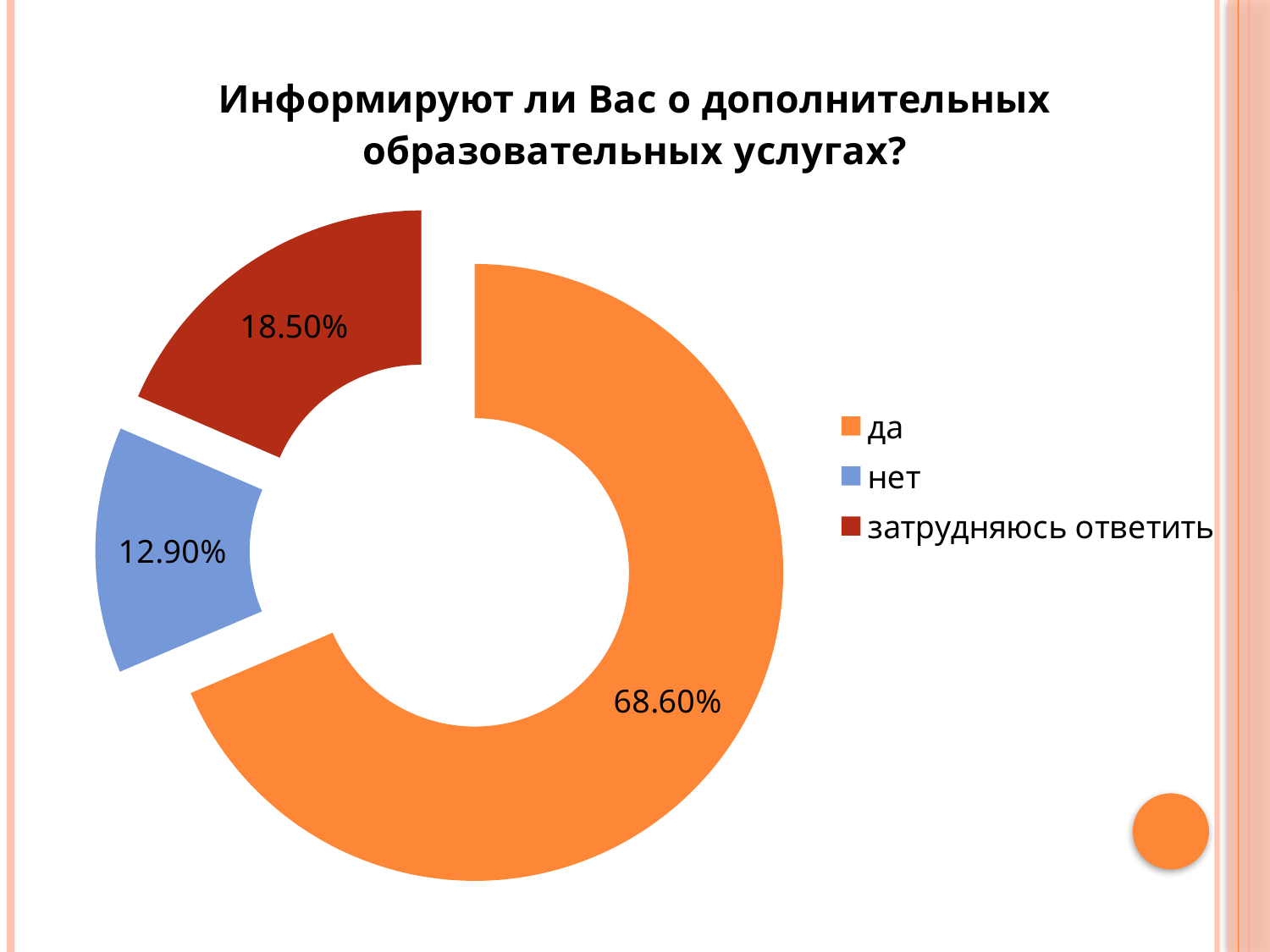
What colour is the segment for "нет"? Blue Which answer has the largest share? да What percentage of respondents answered "затрудняюсь ответить"? 18.50% How many categories does the chart show? 3 What percentage of respondents answered "нет"? 12.90% What is the difference in percentage points between "затрудняюсь ответить" and "нет"? 5.60% Which is larger: the share for "нет" or the share for "затрудняюсь ответить"? затрудняюсь ответить Which answer has the smallest share? нет What is the title of the chart? Информируют ли Вас о дополнительных образовательных услугах? What is the difference in percentage points between "да" and "нет"? 55.70% What kind of chart is shown on the slide? Doughnut chart What percentage of respondents answered "да"? 68.60%